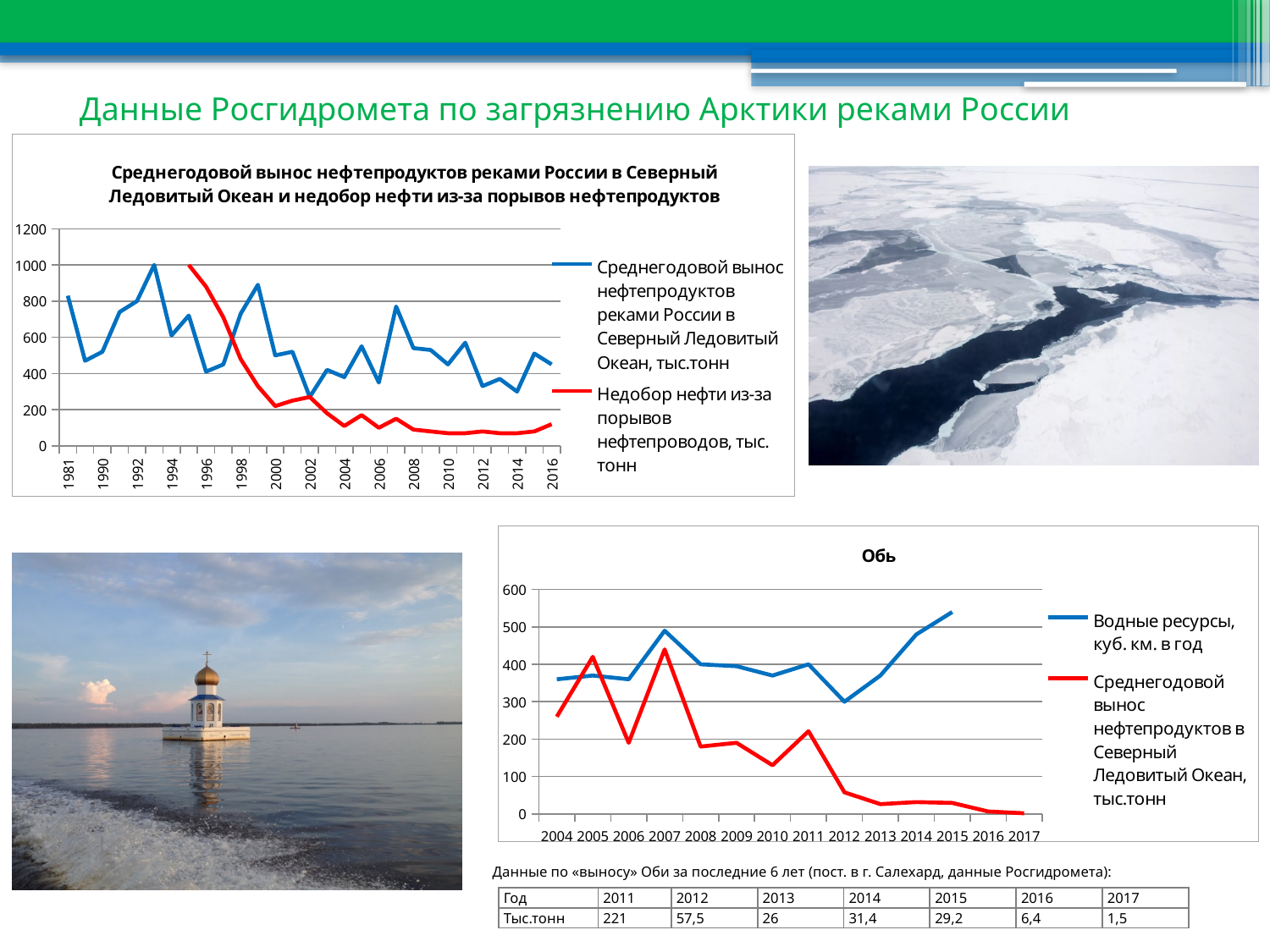
In the «Обь» chart, which year has the highest value of «Водные ресурсы»? 2015 In the «Обь» chart, which series has the larger value in 2005: «Водные ресурсы» or «Среднегодовой вынос нефтепродуктов»? Среднегодовой вынос нефтепродуктов What kind of chart is the top-left chart titled «Среднегодовой вынос нефтепродуктов реками России в Северный Ледовитый Океан и недобор нефти из-за порывов нефтепродуктов»? Line chart In the «Обь» chart, what is the value of «Среднегодовой вынос нефтепродуктов» in 2011 (тыс.тонн)? 221 In the «Обь» chart, is the value of «Водные ресурсы» in 2012 greater or less than 400? less What is the title of the bottom-right chart? Обь How many years are shown on the x axis of the «Обь» chart? 14 How many series does the legend of the top-left chart list? 2 In the top-left chart, does the red series «Недобор нефти из-за порывов нефтепроводов» rise or fall from 1995 to 2016? Falls In the top-left chart, is the value of the blue series in 1993 greater or less than 800? greater How many series does the legend of the «Обь» chart list? 2 In the «Обь» chart, is the value of «Водные ресурсы» in 2015 greater or less than 500? greater